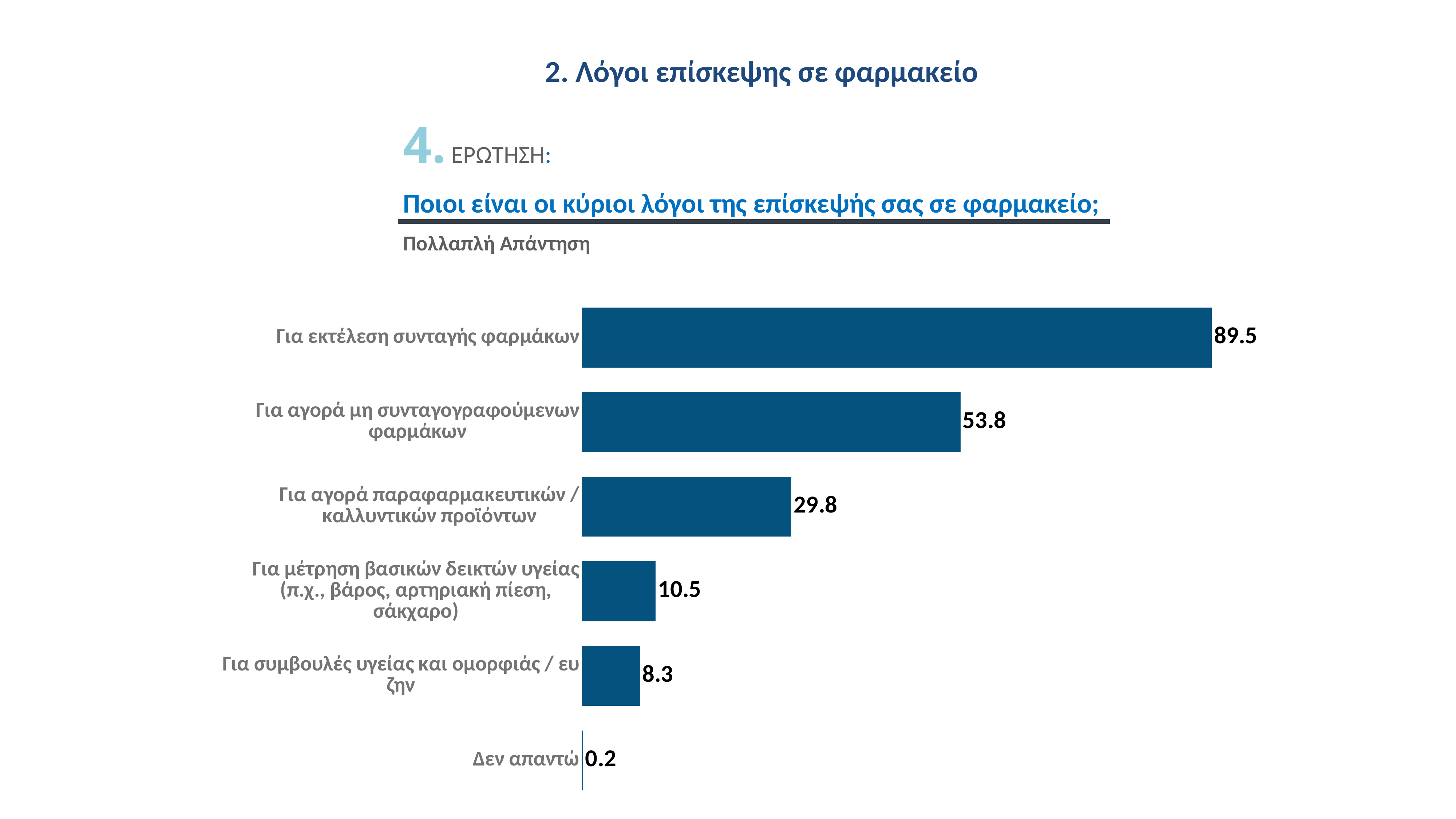
What is the value for "Για αγορά μη συνταγογραφούμενων φαρμάκων"? 53.8 What is the question text shown above the chart? Ποιοι είναι οι κύριοι λόγοι της επίσκεψής σας σε φαρμακείο; What is the difference between the values for "Για εκτέλεση συνταγής φαρμάκων" and "Για αγορά μη συνταγογραφούμενων φαρμάκων"? 35.7 Which category has the lowest value? Δεν απαντώ How many categories are shown in the chart? 6 What is the value for "Για εκτέλεση συνταγής φαρμάκων"? 89.5 What is the value for "Για συμβουλές υγείας και ομορφιάς / ευ ζην"? 8.3 Which is larger: the value for "Για μέτρηση βασικών δεικτών υγείας" or for "Για συμβουλές υγείας και ομορφιάς / ευ ζην"? Για μέτρηση βασικών δεικτών υγείας Which category has the highest value? Για εκτέλεση συνταγής φαρμάκων What kind of chart is shown on the slide? Bar chart What is the value for "Δεν απαντώ"? 0.2 What is the value for "Για αγορά παραφαρμακευτικών / καλλυντικών προϊόντων"? 29.8